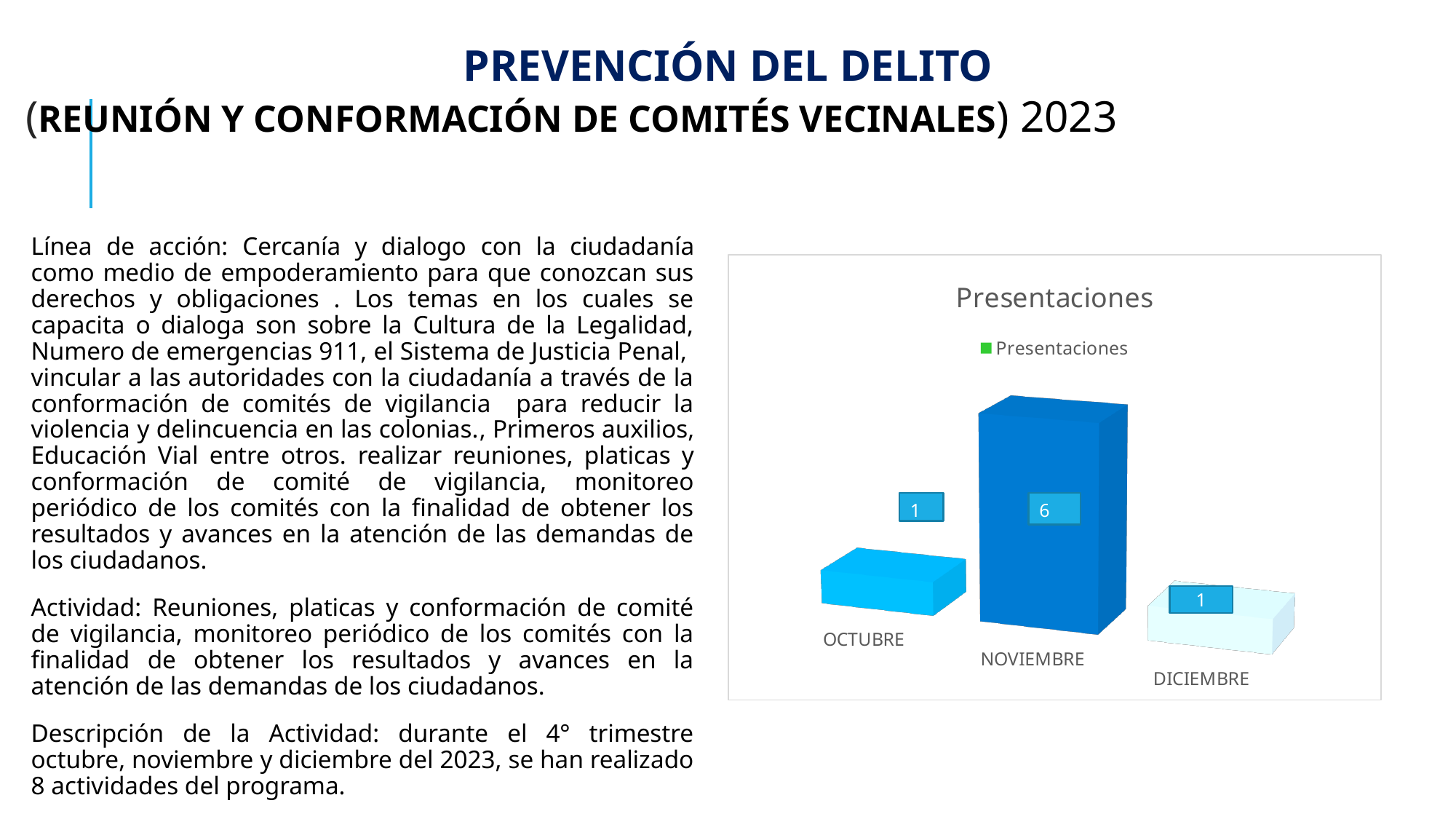
How many categories are shown in the Presentaciones chart? 3 What kind of chart is the Presentaciones chart? bar chart What is the total of the values for OCTUBRE, NOVIEMBRE and DICIEMBRE in the Presentaciones chart? 8 How many series does the legend of the Presentaciones chart list? 1 What is the value for NOVIEMBRE in the Presentaciones chart? 6 Which is larger in the Presentaciones chart, the value for NOVIEMBRE or the value for DICIEMBRE? NOVIEMBRE What is the value for DICIEMBRE in the Presentaciones chart? 1 What is the difference between the values for NOVIEMBRE and OCTUBRE in the Presentaciones chart? 5 What is the name of the series listed in the legend of the chart? Presentaciones Which month has the highest value in the Presentaciones chart? NOVIEMBRE What is the title of the chart on the slide? Presentaciones What is the value for OCTUBRE in the Presentaciones chart? 1